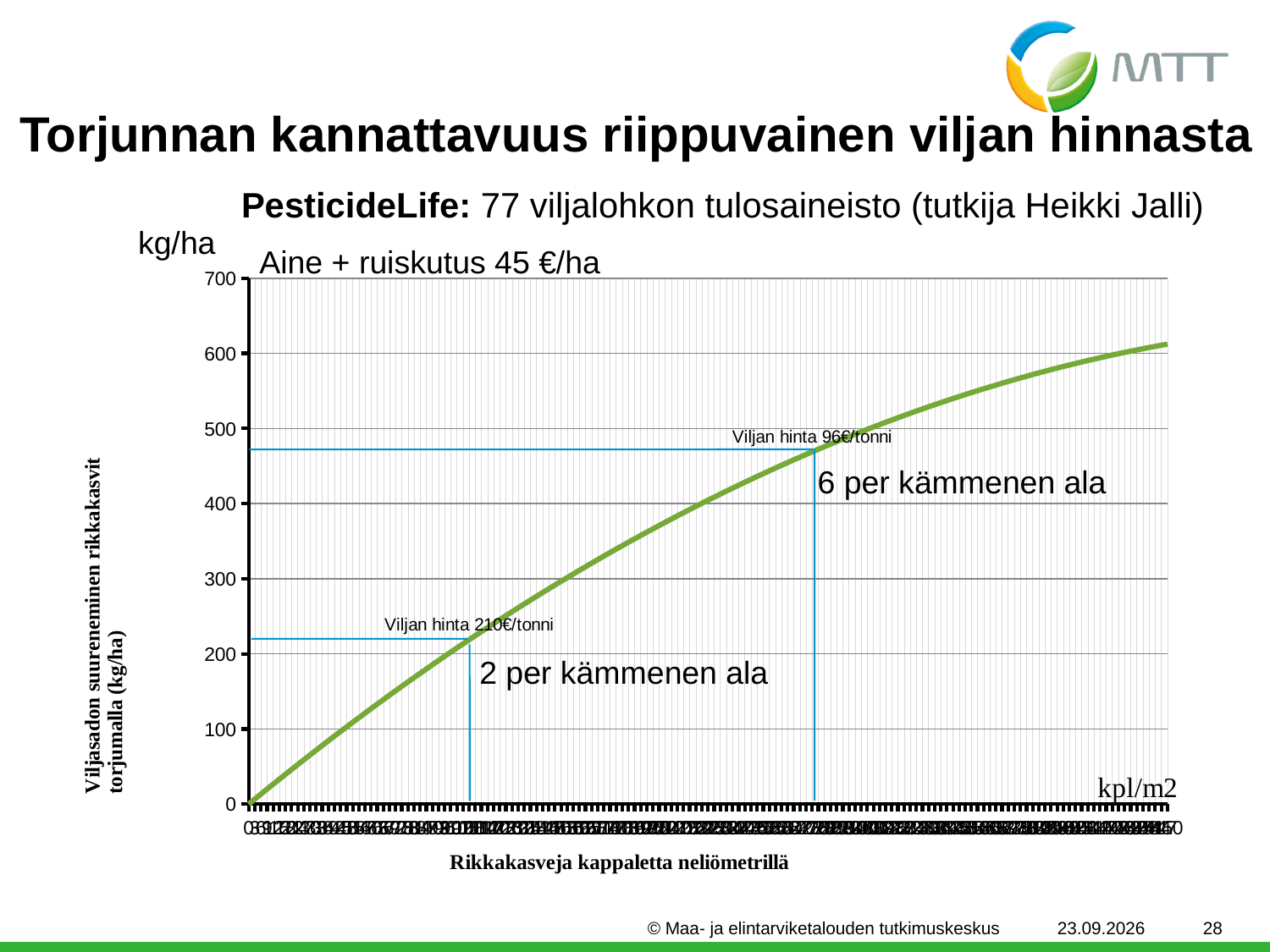
How many data series are plotted on the chart? 1 Is the value of the curve at the point marked 'Viljan hinta 210€/tonni' greater or less than 300? less What kind of chart is shown on the slide? line chart Which marked point has the higher value on the curve: 'Viljan hinta 96€/tonni' or 'Viljan hinta 210€/tonni'? Viljan hinta 96€/tonni Does the plotted curve rise or fall as the number of weeds per square metre increases along the x axis? rise What is the highest tick value shown on the y axis? 700 Is the value of the curve at the point marked 'Viljan hinta 96€/tonni' greater or less than 400? greater Is the value of the curve at the point marked 'Viljan hinta 210€/tonni' greater or less than 100? greater What is the x-axis label of the chart? Rikkakasveja kappaletta neliömetrillä What is the title printed above the chart? Aine + ruiskutus 45 €/ha